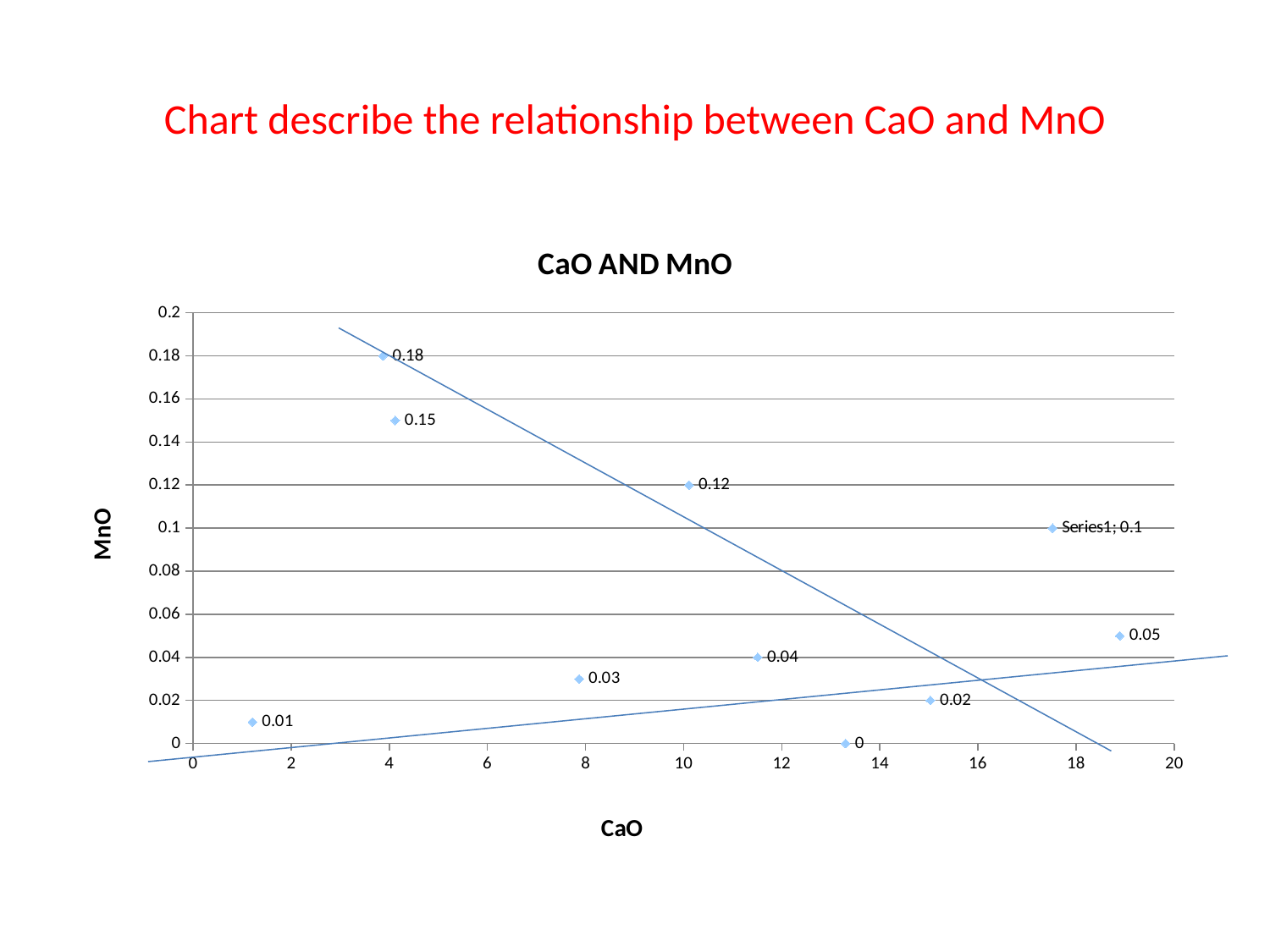
Is the CaO value for the point labelled 0.18 greater or less than 6? less What is the label of the vertical axis? MnO Is the CaO value for the point labelled 0.12 greater or less than 8? greater What is the title of the chart? CaO AND MnO What is the highest MnO value labelled on the chart? 0.18 Is the CaO value for the point labelled 0.05 greater or less than 16? greater How many plotted points have a labelled MnO value greater than 0.1? 3 What is the lowest MnO value labelled on the chart? 0 Which is larger, the point labelled 0.12 or the point labelled 0.1? 0.12 What kind of chart is shown on the slide? scatter chart What is the difference between the two highest labelled MnO values, 0.18 and 0.15? 0.03 How many data points are plotted on the chart? 10